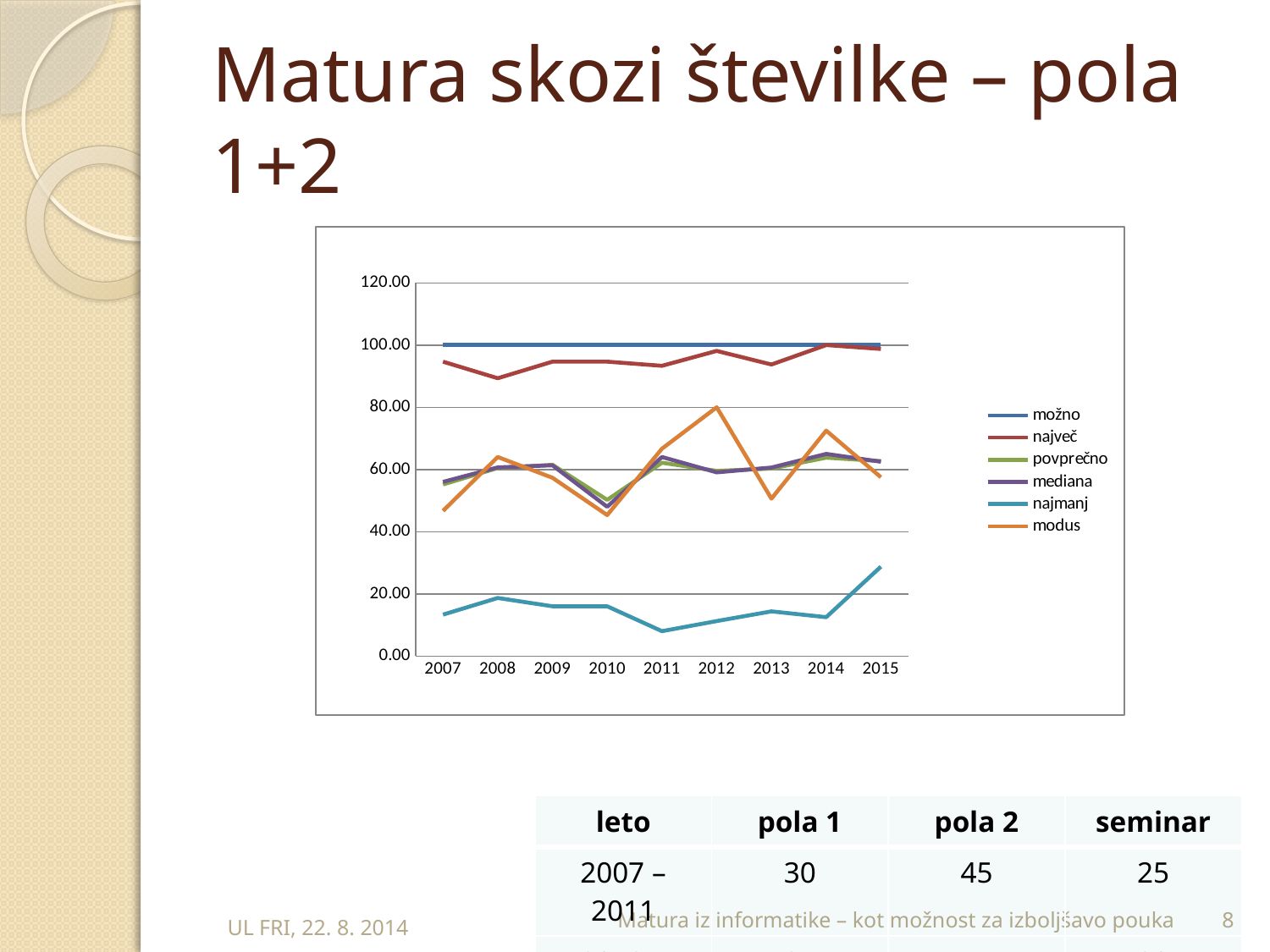
In 2013, which is larger: 'modus' or 'mediana'? mediana What kind of chart is shown on the slide? line chart What is the value of the 'možno' series in 2010? 100.00 How many series does the chart's legend list? 6 How many years are plotted along the x axis of the chart? 9 Is the value of 'najmanj' in 2015 greater or less than 20.00? greater In which year does the 'najmanj' series reach its lowest value? 2011 Is the value of 'modus' in 2012 greater or less than 60.00? greater In which year is the 'največ' series at its lowest? 2008 In which year does the 'modus' series reach its highest value? 2012 Does the 'možno' series rise, fall or stay constant from 2007 to 2015? stays constant Is the value of 'modus' in 2010 greater or less than 60.00? less